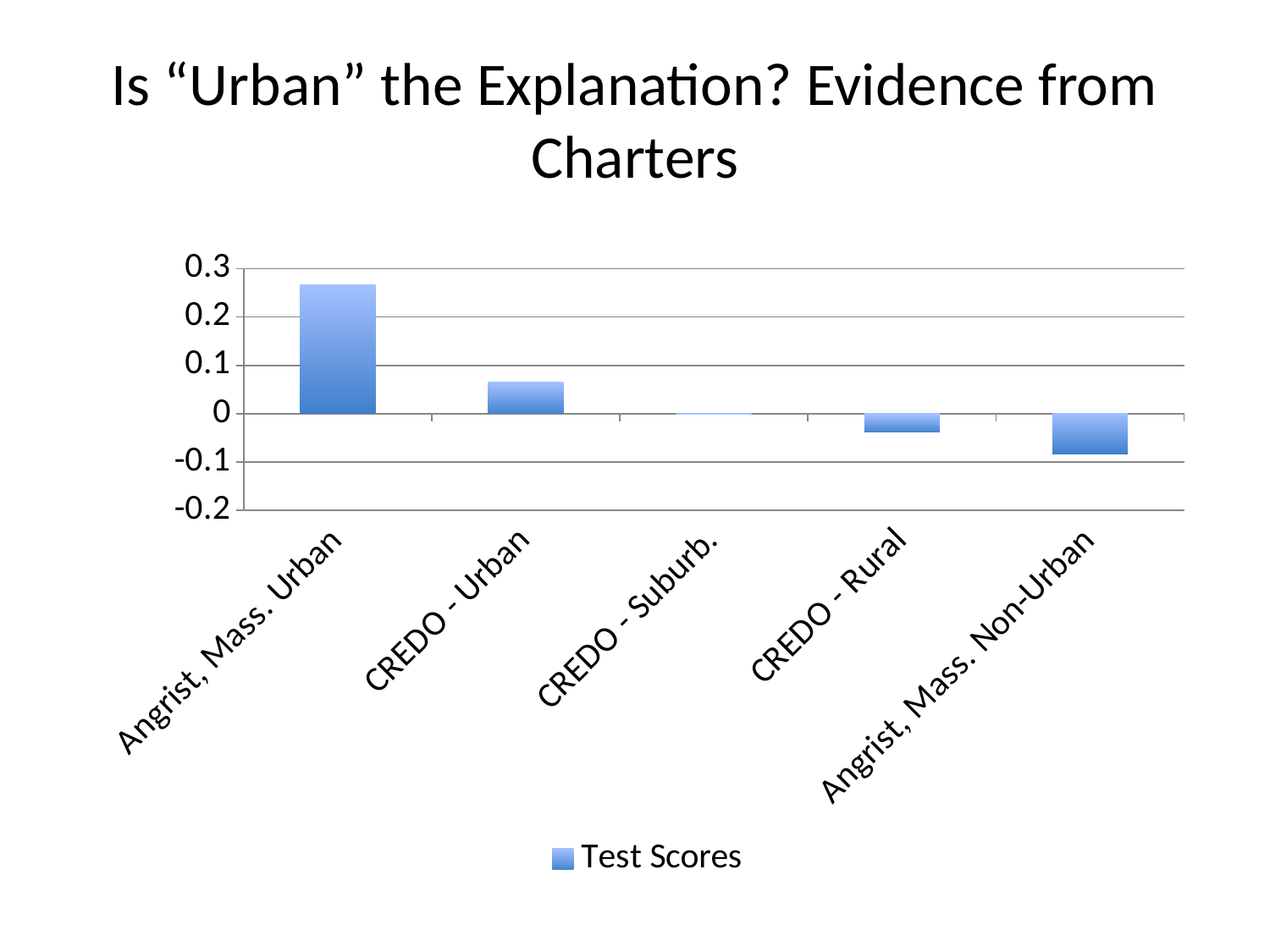
Is the value for Angrist, Mass. Urban greater or less than 0.2? greater How many categories are shown on the x axis of the chart? 5 How many series does the chart's legend list? 1 Which category has the highest value in the chart? Angrist, Mass. Urban Which is larger, the value for CREDO - Urban or the value for CREDO - Rural? CREDO - Urban Is the value for CREDO - Urban greater or less than 0.1? less Which category has the lowest value in the chart? Angrist, Mass. Non-Urban Do the values generally rise or fall moving from left to right along the x axis? fall Is the value for Angrist, Mass. Non-Urban greater or less than 0? less What is the name of the series listed in the chart's legend? Test Scores What kind of chart is shown on the slide? bar chart